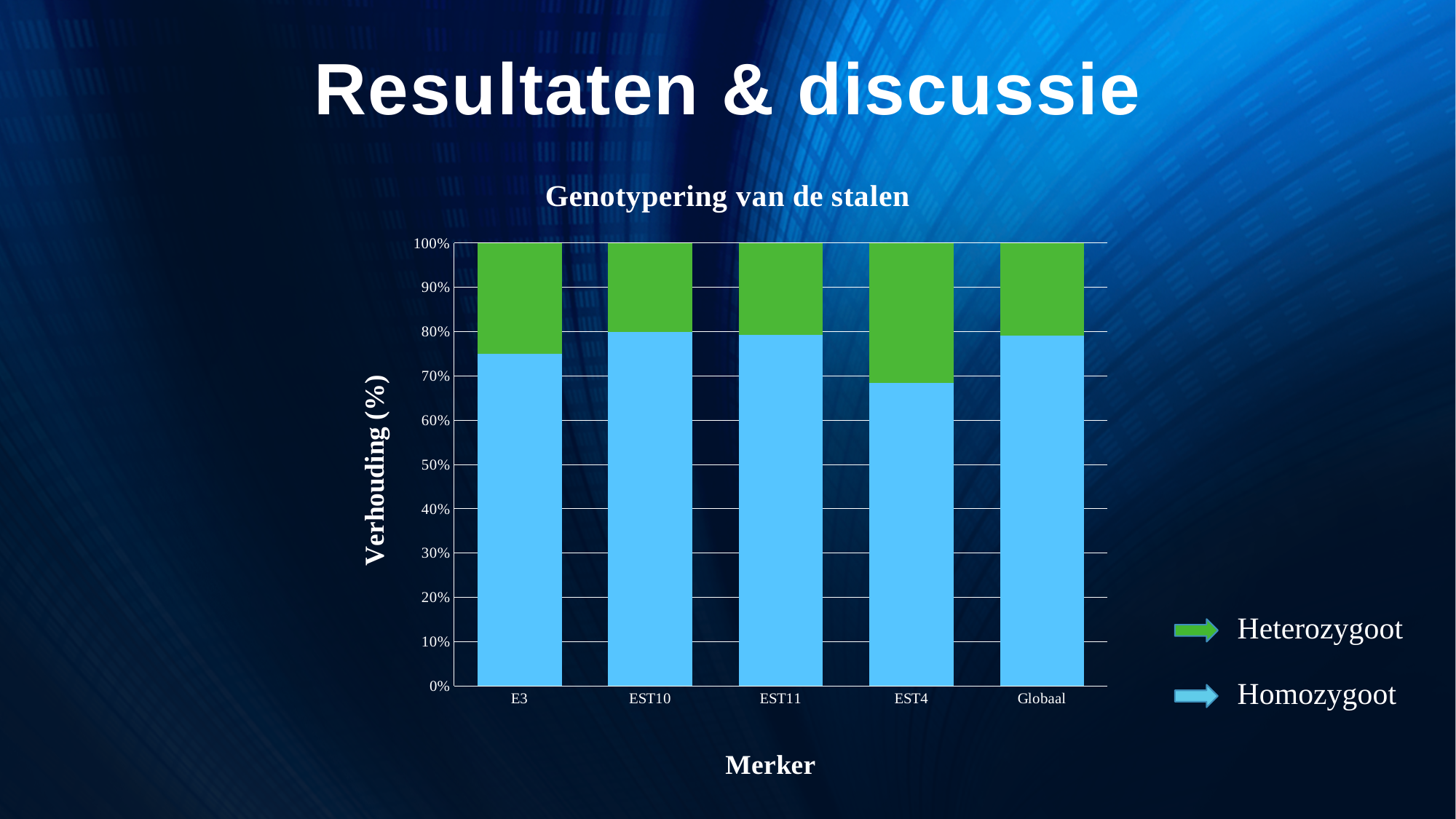
Which marker has the highest Heterozygoot share? EST4 What is the total of the stacked bar for Globaal? 100% Which colour represents Heterozygoot in the chart? Green Which marker has the lowest Homozygoot share? EST4 Is the Heterozygoot share for EST4 greater or less than 20%? greater How many series does the legend list? 2 How many markers (categories) are shown on the x axis of the chart? 5 Which has the larger Homozygoot share, E3 or EST4? E3 Is the Homozygoot share for EST10 greater or less than 70%? greater What kind of chart is shown on the slide? Stacked bar chart What is the title of the chart? Genotypering van de stalen Is the Homozygoot share for E3 greater or less than 70%? greater